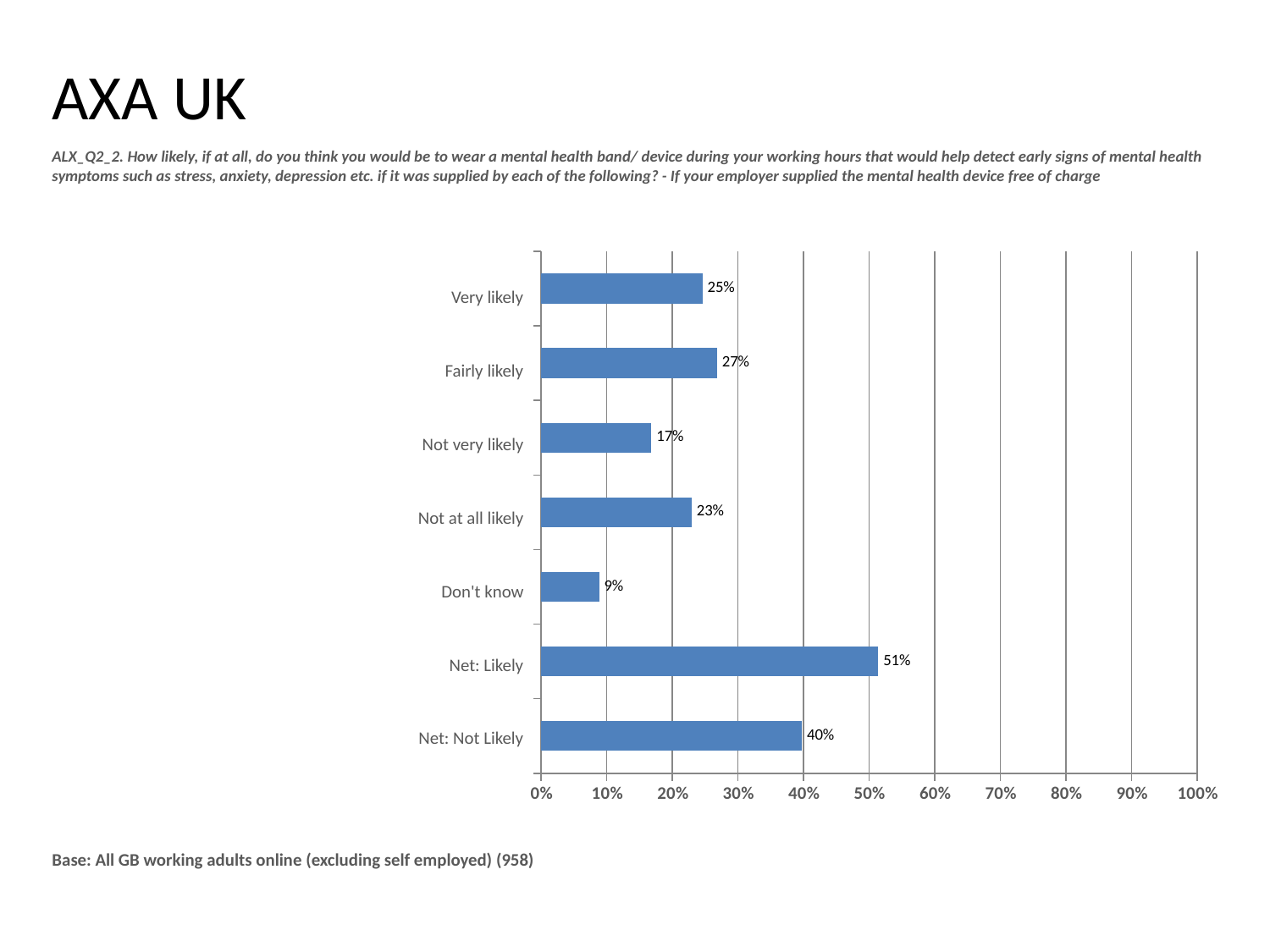
What is the value for "Fairly likely"? 27% Is the value for "Net: Likely" greater or less than 50%? greater What is the value for "Very likely"? 25% What is the difference between "Net: Likely" and "Net: Not Likely"? 11% Which is larger, "Not very likely" or "Not at all likely"? Not at all likely What is the value for "Net: Not Likely"? 40% What is the value for "Don't know"? 9% What kind of chart is shown on the slide? Bar chart How many categories are shown on the chart? 7 What is the maximum value shown on the horizontal axis? 100% Which category has the lowest value? Don't know Which category has the highest value? Net: Likely